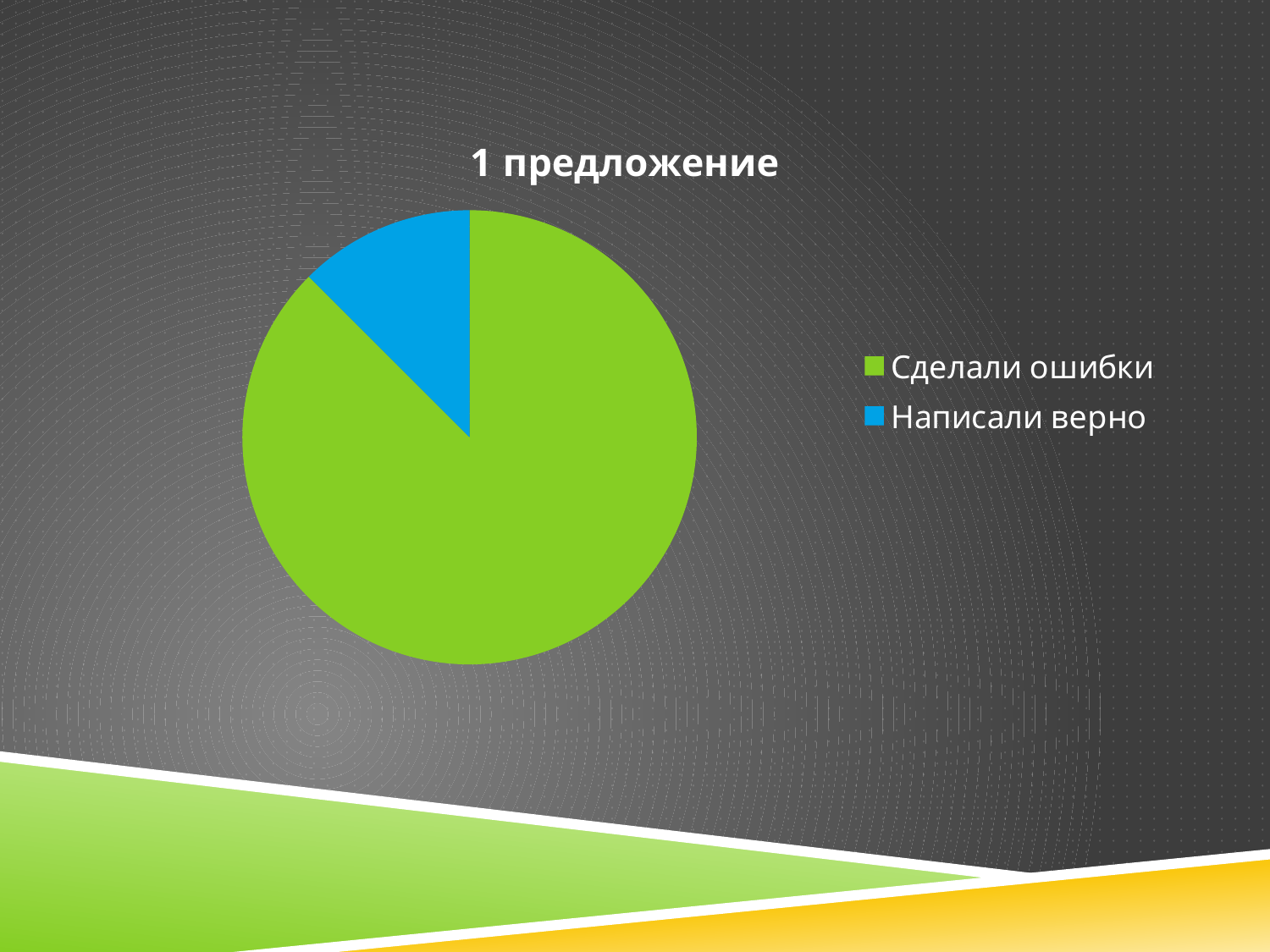
Which category has the largest slice of the pie? Сделали ошибки Which category has the smallest slice of the pie? Написали верно How many slices does the pie chart have? 2 What is the title of the chart? 1 предложение Does the "Сделали ошибки" slice take up more or less than half of the pie? more Which slice is larger, "Сделали ошибки" or "Написали верно"? Сделали ошибки What kind of chart is shown on the slide? pie chart What colour is the slice for "Написали верно"? blue How many entries does the legend list? 2